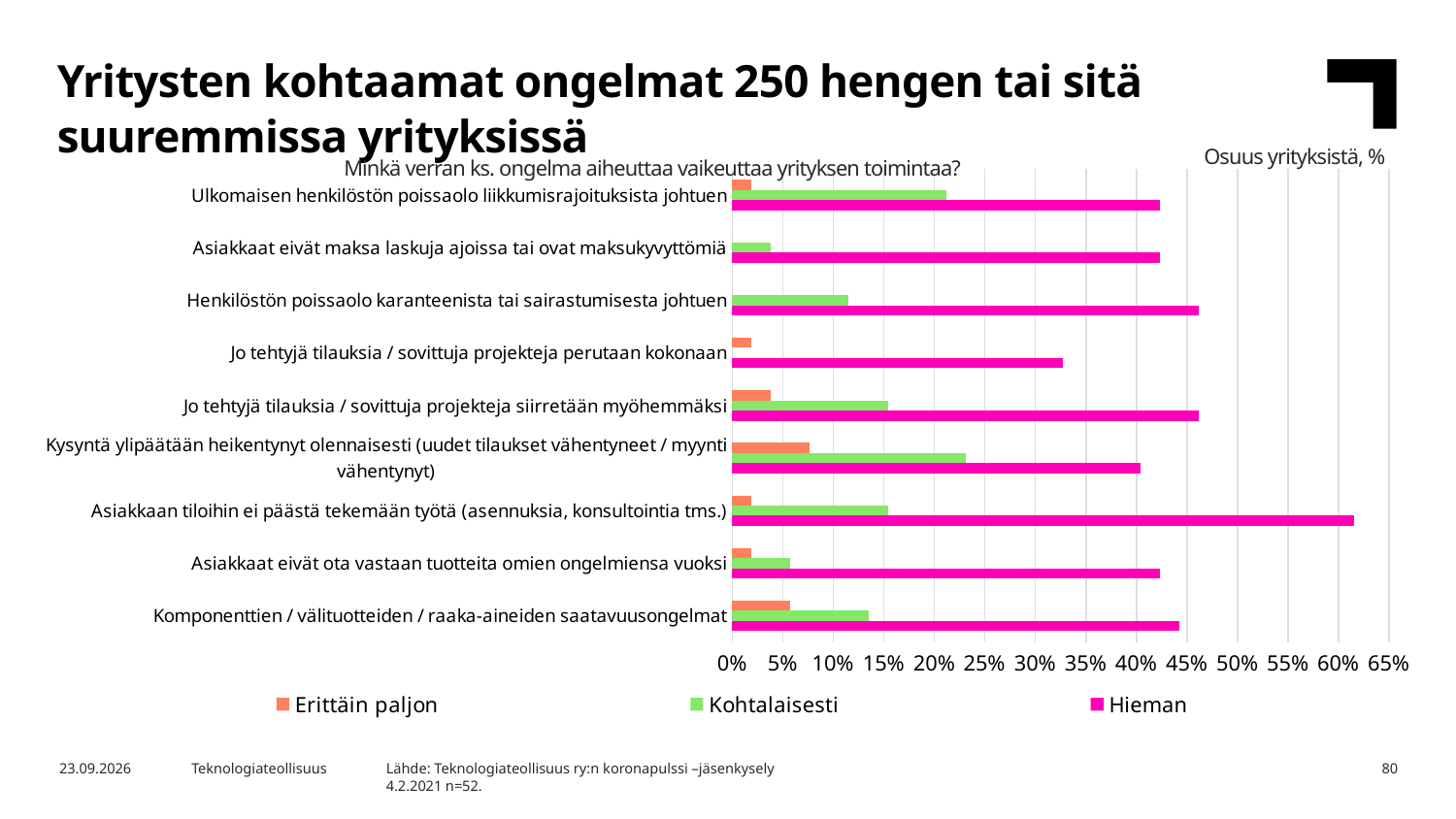
How many series does the legend list? 3 Which category has the lowest value for the 'Hieman' series? Jo tehtyjä tilauksia / sovittuja projekteja perutaan kokonaan For the 'Kohtalaisesti' series, which is larger: 'Ulkomaisen henkilöstön poissaolo liikkumisrajoituksista johtuen' or 'Asiakkaat eivät maksa laskuja ajoissa tai ovat maksukyvyttömiä'? Ulkomaisen henkilöstön poissaolo liikkumisrajoituksista johtuen How many problem categories are plotted on the chart? 9 For the 'Hieman' series, which is larger: 'Asiakkaan tiloihin ei päästä tekemään työtä' or 'Kysyntä ylipäätään heikentynyt olennaisesti'? Asiakkaan tiloihin ei päästä tekemään työtä Is the 'Hieman' value for 'Jo tehtyjä tilauksia / sovittuja projekteja perutaan kokonaan' greater or less than 35%? less Which category has the highest value for the 'Hieman' series? Asiakkaan tiloihin ei päästä tekemään työtä (asennuksia, konsultointia tms.) Is the 'Kohtalaisesti' value for 'Kysyntä ylipäätään heikentynyt olennaisesti' greater or less than 20%? greater What kind of chart is shown on the slide? Bar chart Is the 'Kohtalaisesti' value for 'Ulkomaisen henkilöstön poissaolo liikkumisrajoituksista johtuen' greater or less than 15%? greater Which colour represents the 'Hieman' series in the legend? Magenta (pink)